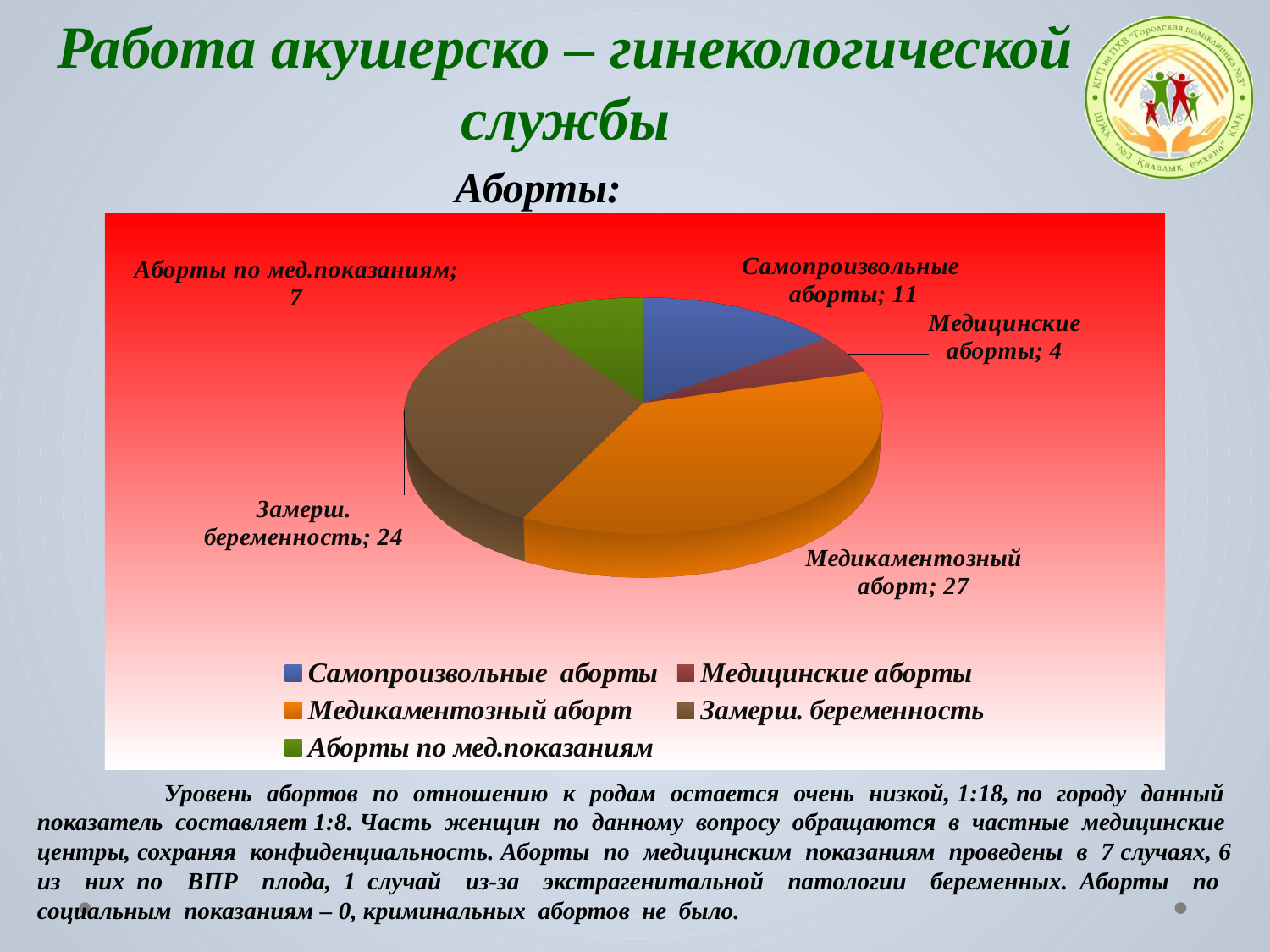
What is the value for Аборты по мед.показаниям? 7 What is the value for Самопроизвольные аборты? 11 What is the difference between the values for Медикаментозный аборт and Замерш. беременность? 3 How many slices does the pie chart have? 5 Which category has the smallest value in the pie chart? Медицинские аборты What is the value for Медицинские аборты? 4 Which category has the largest value in the pie chart? Медикаментозный аборт How many entries does the legend of the pie chart list? 5 Which is larger, the value for Самопроизвольные аборты or the value for Аборты по мед.показаниям? Самопроизвольные аборты What is the value for Медикаментозный аборт? 27 What is the value for Замерш. беременность? 24 What type of chart is shown on the slide? Pie chart